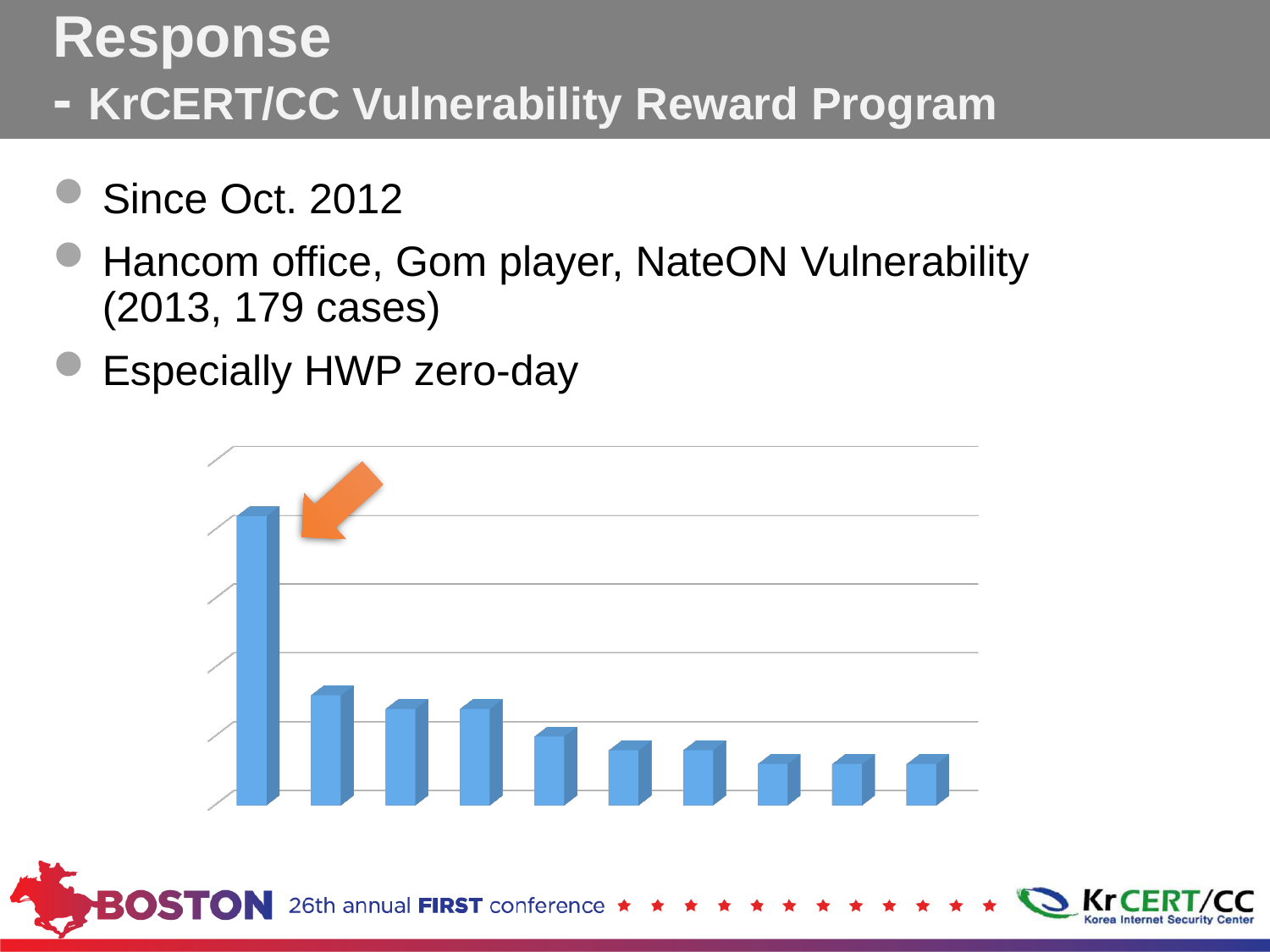
Do the bar values generally rise or fall from left to right across the chart? fall How many bars does the chart show? 10 Which bar does the orange arrow on the chart point to? the first (leftmost) bar Which bar is the tallest in the chart? the first (leftmost) bar Is the first (leftmost) bar taller or shorter than the second bar? taller What kind of chart is shown on the slide? bar chart Is the second bar taller or shorter than the fifth bar? taller What colour are the bars in the chart? blue